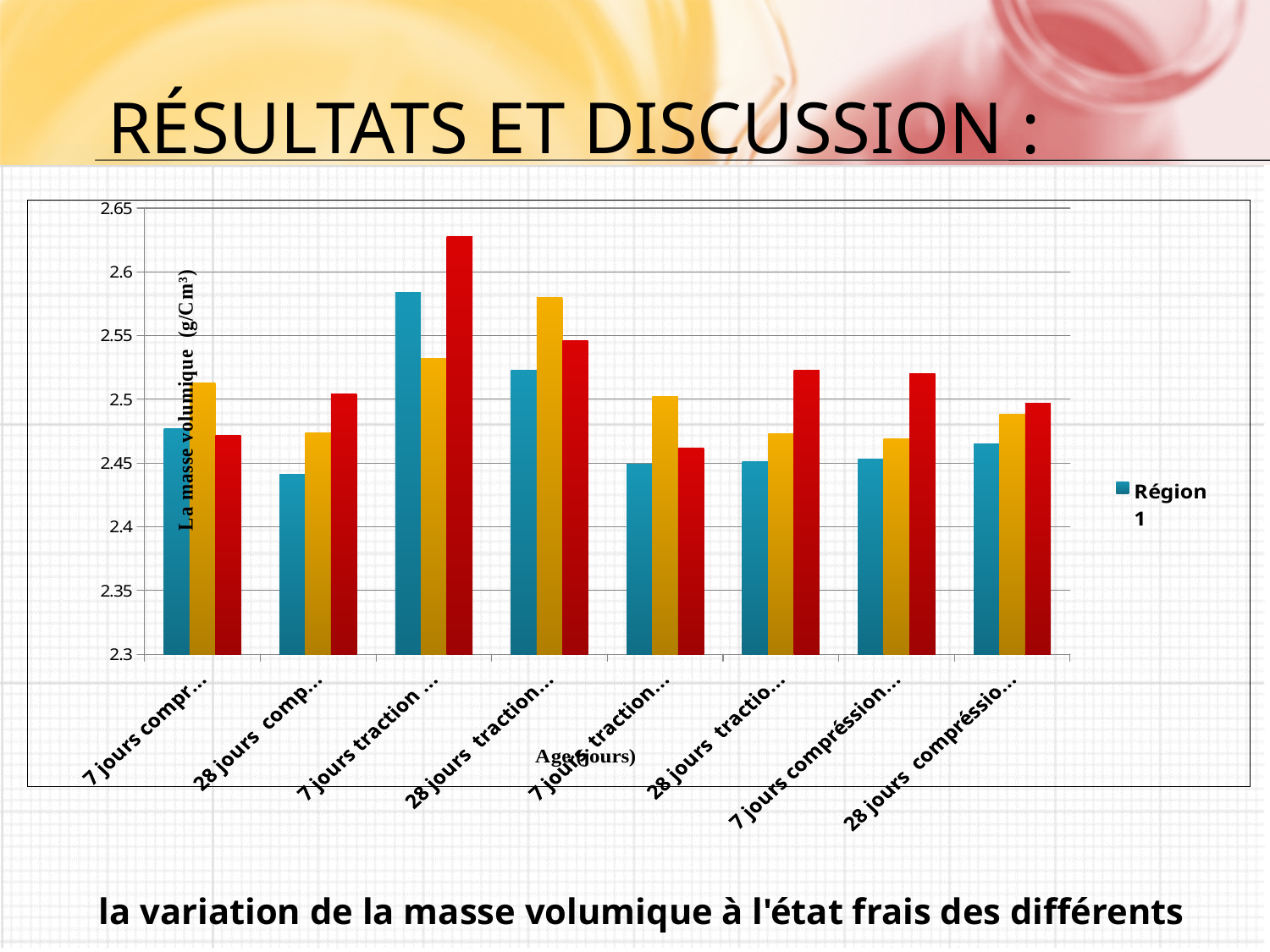
Is the value of the yellow bar in the fourth category group (28 jours traction) greater or less than 2.55? greater Is the value of the red bar in the third category group (7 jours traction) greater or less than 2.6? greater In the first category group (7 jours compr...), which is larger, the blue bar or the yellow bar? the yellow bar Which category group contains the shortest bar in the chart? 28 jours comp... (second group from the left) What kind of chart is shown on the slide? bar chart Is the value of the blue bar in the second category group (28 jours comp...) greater or less than 2.45? less Which category group contains the tallest bar in the chart? 7 jours traction (third group from the left) What is the title of the vertical axis of the chart? La masse volumique (g/Cm³) What is the legend entry shown to the right of the chart? Région 1 How many categories are plotted along the x axis of the chart? 8 In the third category group (7 jours traction), which is larger, the blue bar or the yellow bar? the blue bar